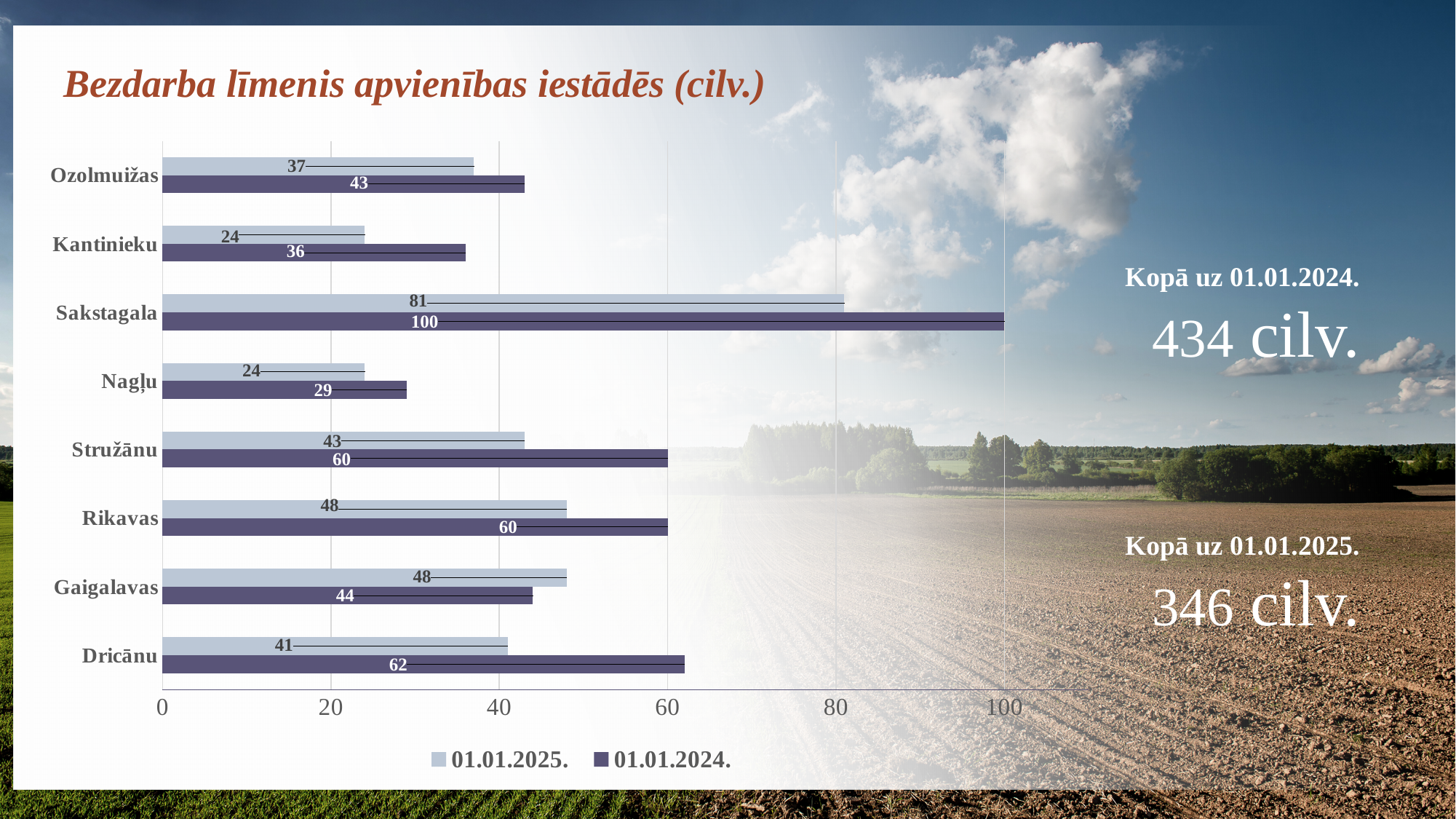
What is the value for Kantinieku in the 01.01.2025. series? 24 What is the value for Sakstagala in the 01.01.2024. series? 100 What kind of chart is shown on the slide? bar chart What is the difference between the 01.01.2024. and 01.01.2025. values for Dricānu? 21 What is the title of the chart? Bezdarba līmenis apvienības iestādēs (cilv.) Which category has the lowest value in the 01.01.2024. series? Nagļu How many series does the legend list? 2 What is the difference between the 01.01.2024. and 01.01.2025. values for Sakstagala? 19 Is the 01.01.2024. value for Stružānu greater or less than 40? greater How many categories are shown on the chart? 8 Which is larger for Gaigalavas: the 01.01.2025. value or the 01.01.2024. value? 01.01.2025. Which category has the highest value in the 01.01.2025. series? Sakstagala